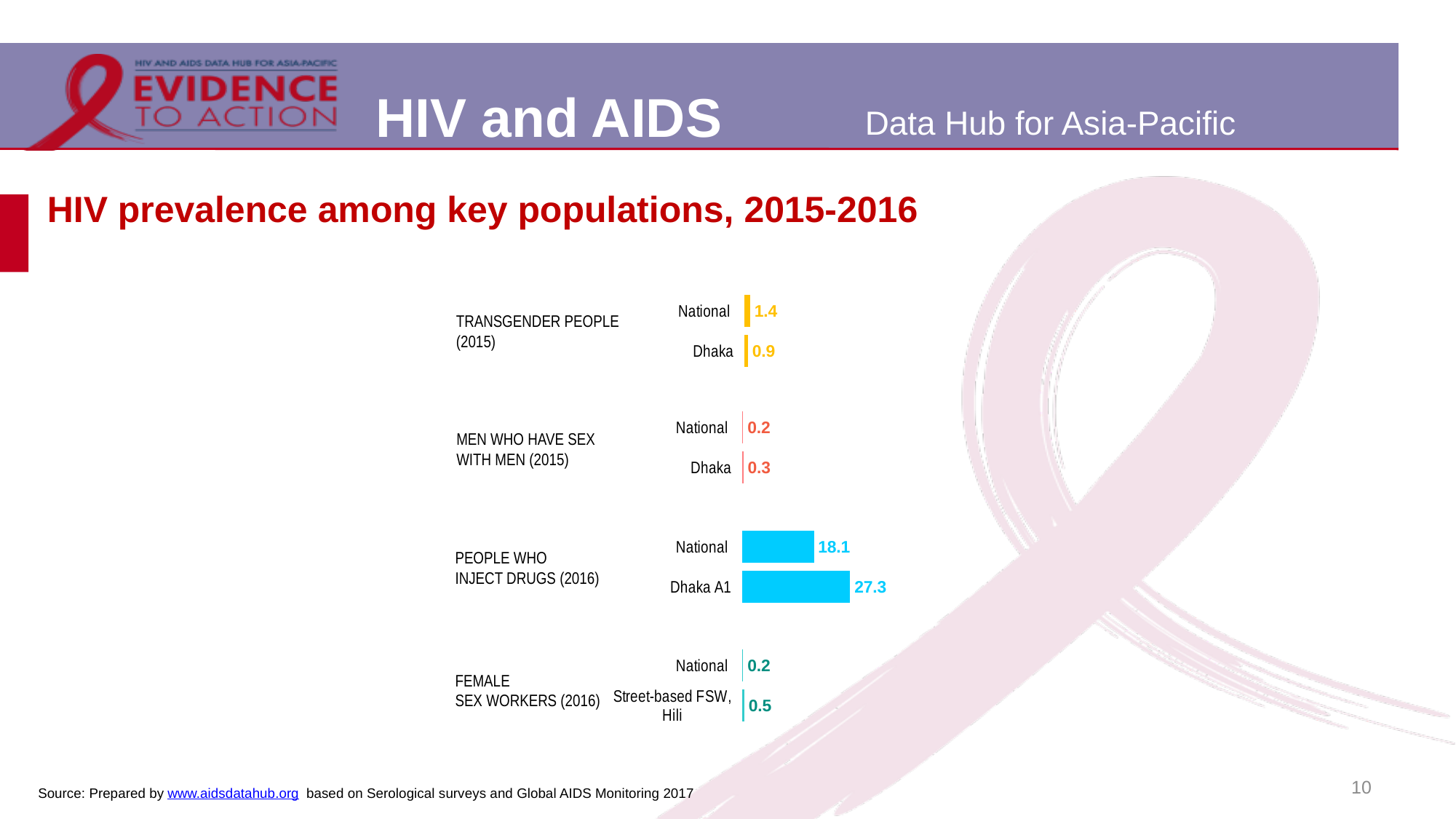
What is the HIV prevalence among transgender people (2015) in Dhaka? 0.9 What type of chart is shown on the slide? Bar chart How many bars are plotted on the chart? 8 What is the HIV prevalence among transgender people (2015) at the national level? 1.4 What is the national HIV prevalence among people who inject drugs (2016)? 18.1 What is the difference between the national and Dhaka HIV prevalence among transgender people (2015)? 0.5 What is the HIV prevalence among people who inject drugs (2016) in Dhaka A1? 27.3 Which bar shows the highest HIV prevalence on the chart? Dhaka A1 (people who inject drugs, 2016) What is the difference between the Dhaka A1 and national HIV prevalence among people who inject drugs (2016)? 9.2 Which is larger: the national HIV prevalence among transgender people (2015) or the Dhaka value? National What is the HIV prevalence among men who have sex with men (2015) in Dhaka? 0.3 What is the HIV prevalence among street-based FSW in Hili (2016)? 0.5